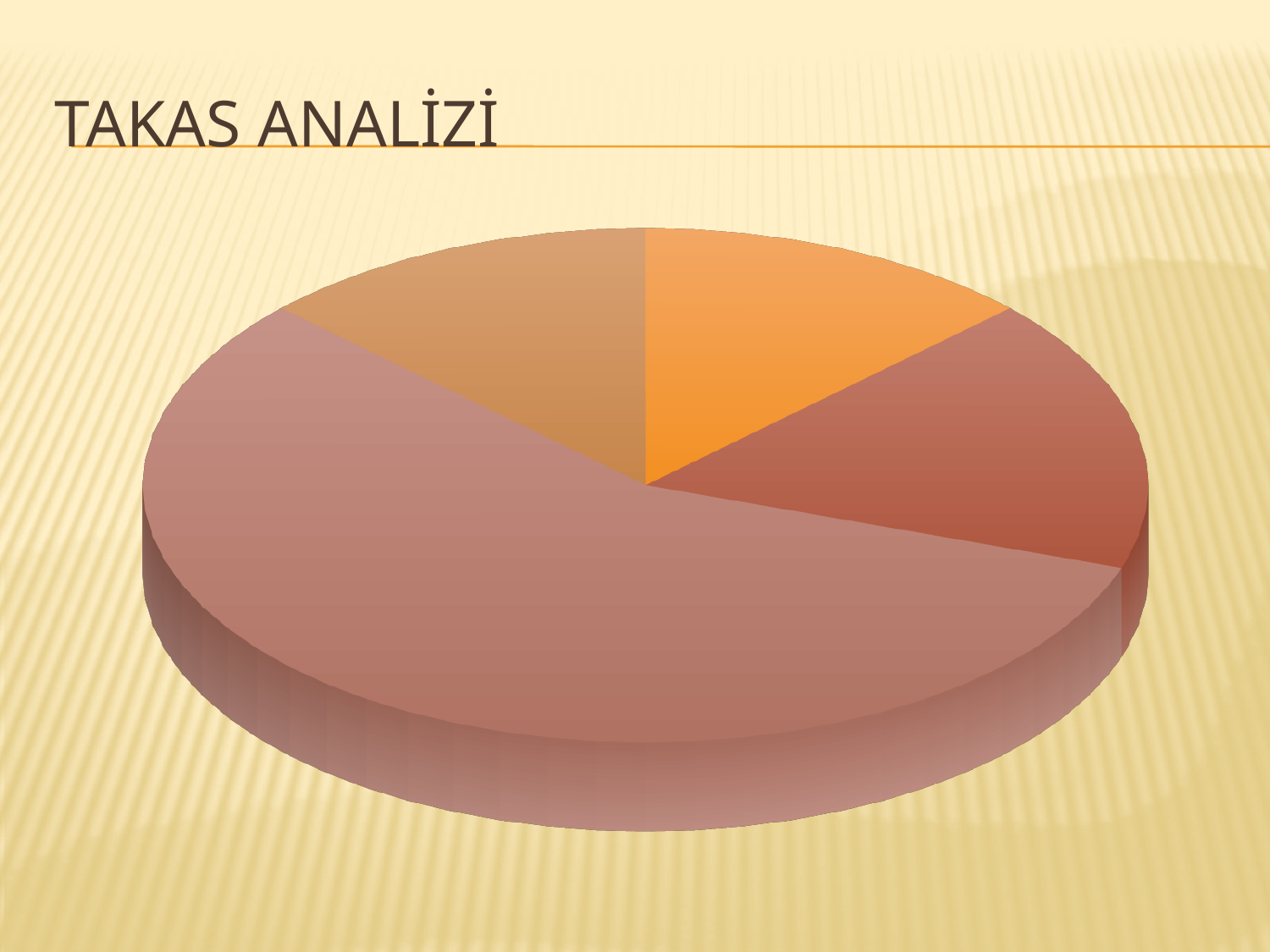
How many slices does the pie chart have? 4 Does the pie chart display a legend or data labels? No Which slice of the pie chart is the largest? The pinkish-brown slice What kind of chart is shown on the slide? Pie chart What is the title of the slide containing the pie chart? TAKAS ANALİZİ